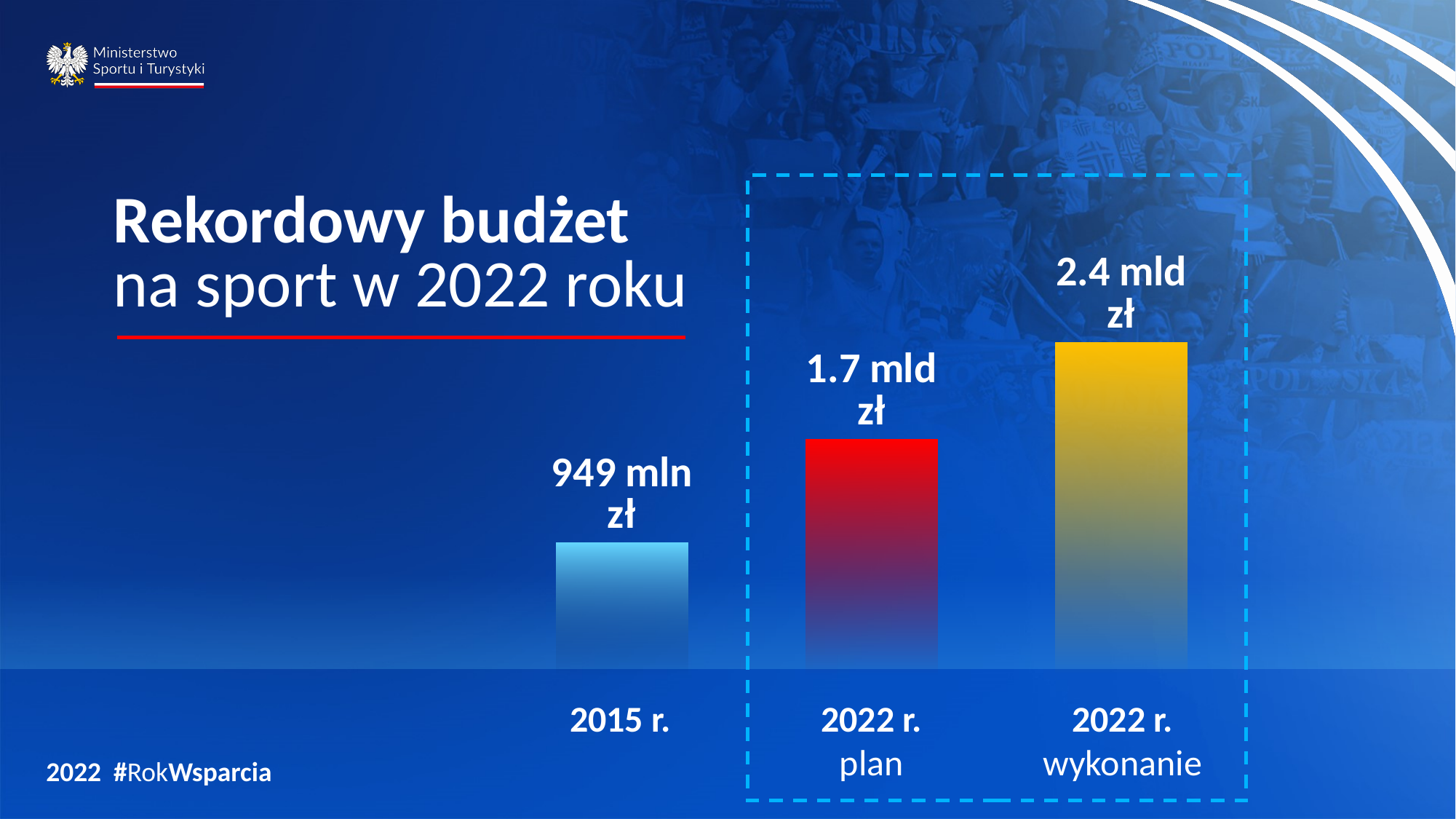
What is the difference between the 2022 r. wykonanie value and the 2022 r. plan value? 0.7 mld zł What is the title of the slide? Rekordowy budżet na sport w 2022 roku Which category has the highest value? 2022 r. wykonanie Which category has the lowest value? 2015 r. What is the value shown for 2022 r. plan? 1.7 mld zł What is the value shown for 2015 r.? 949 mln zł Which is larger, the value for 2022 r. plan or the value for 2015 r.? 2022 r. plan What kind of chart is shown on the slide? bar chart Do the values rise or fall from left to right across the bars? rise How many bars are shown in the chart? 3 Which is larger, the value for 2022 r. wykonanie or the value for 2022 r. plan? 2022 r. wykonanie What is the value shown for 2022 r. wykonanie? 2.4 mld zł